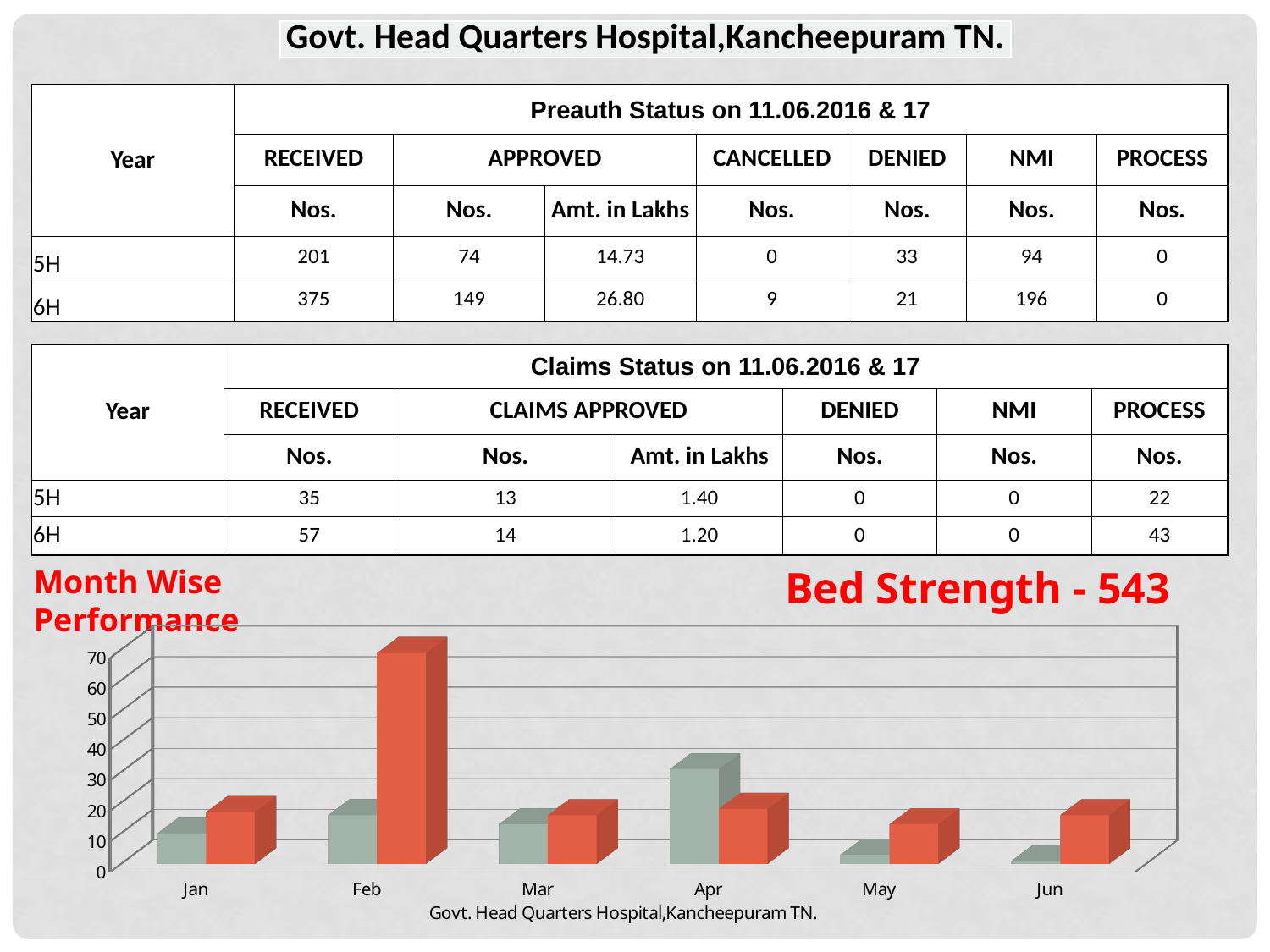
In which month is the grey bar the shortest? Jun How many months are shown on the x axis of the bar chart? 6 Is the grey bar for May greater or less than 10? less In which month is the red bar the tallest? Feb In Feb, which bar is taller, the grey bar or the red bar? the red bar Is the grey bar for Apr greater or less than 20? greater In Apr, which bar is taller, the grey bar or the red bar? the grey bar What kind of chart is shown at the bottom of the slide? bar chart What text appears below the x axis of the bar chart? Govt. Head Quarters Hospital,Kancheepuram TN. Is the red bar for Jan greater or less than 30? less In which month is the grey bar the tallest? Apr